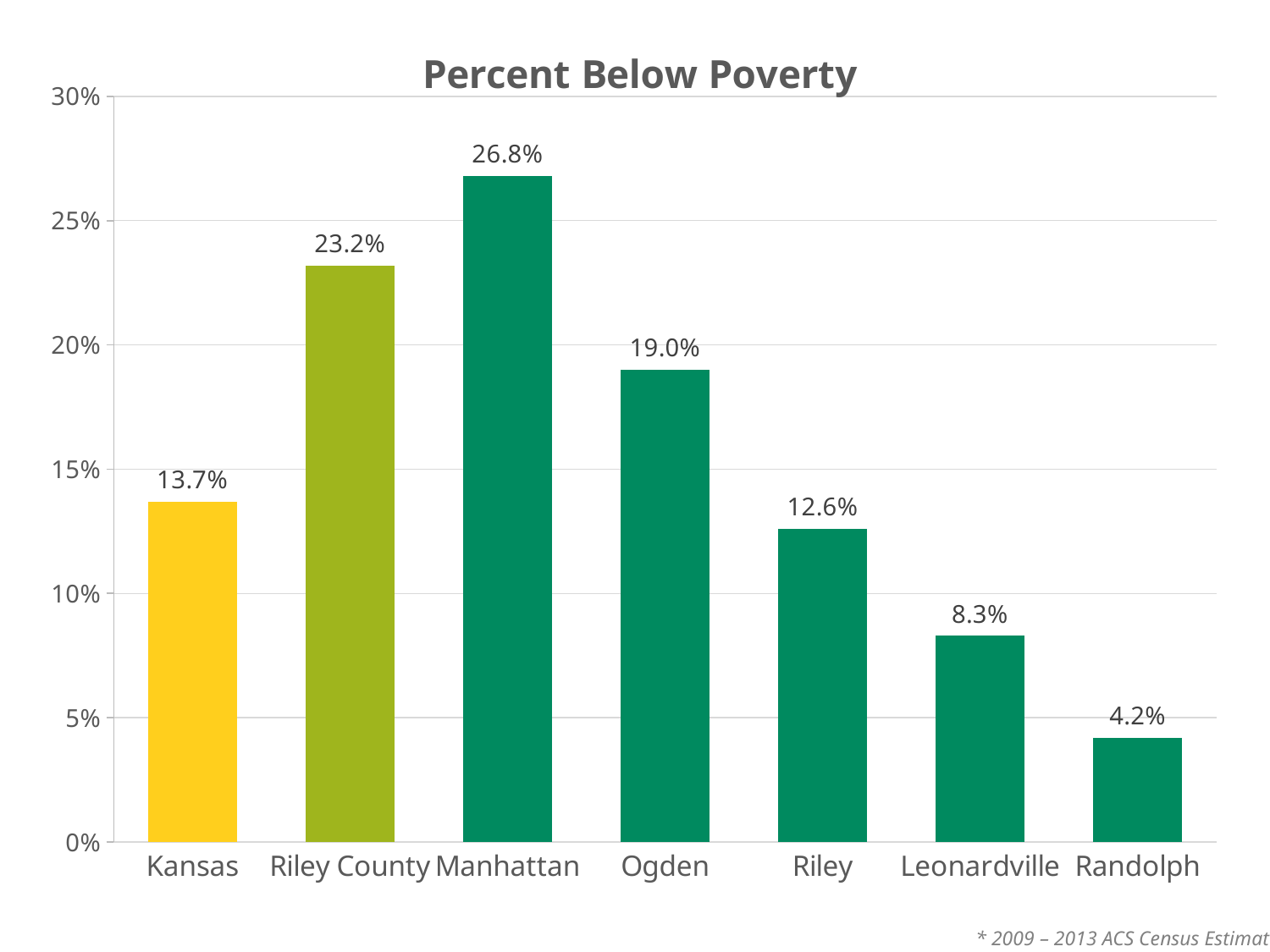
Which category has the lowest percent below poverty? Randolph What is the percent below poverty for Kansas? 13.7% What is the difference between the percent below poverty for Ogden and Riley? 6.4% What is the percent below poverty for Leonardville? 8.3% What kind of chart is shown on the slide? Bar chart What is the percent below poverty for Manhattan? 26.8% Is the value for Riley County greater or less than 20%? greater What is the title of the chart? Percent Below Poverty How many categories are shown on the chart? 7 Which category has the highest percent below poverty? Manhattan What is the difference between the percent below poverty for Riley County and Kansas? 9.5% Which has a higher percent below poverty, Ogden or Riley? Ogden